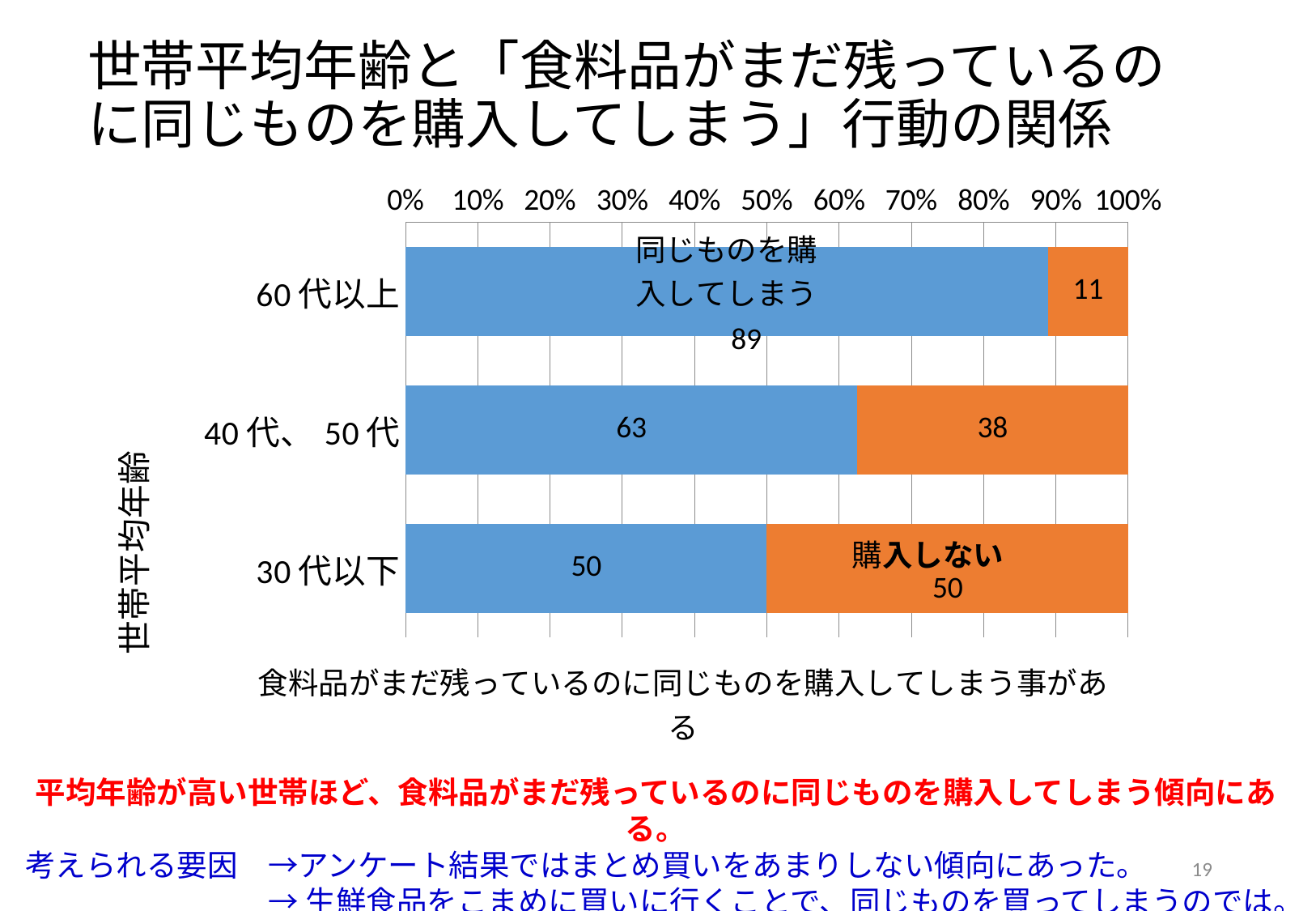
Which age category has the highest value for 同じものを購入してしまう? 60代以上 What is the difference between the 同じものを購入してしまう values for 60代以上 and 30代以下? 39 What type of chart is shown on the slide? Stacked bar chart Which age category has the lowest value for 購入しない? 60代以上 What is the value of 購入しない for 60代以上? 11 What is the label of the y axis? 世帯平均年齢 What is the value of 同じものを購入してしまう for 60代以上? 89 Which is larger: the 購入しない value for 40代、50代 or for 60代以上? 40代、50代 How many age categories are plotted on the chart? 3 What is the value of 同じものを購入してしまう for 30代以下? 50 What is the value of 同じものを購入してしまう for 40代、50代? 63 What is the value of 購入しない for 40代、50代? 38